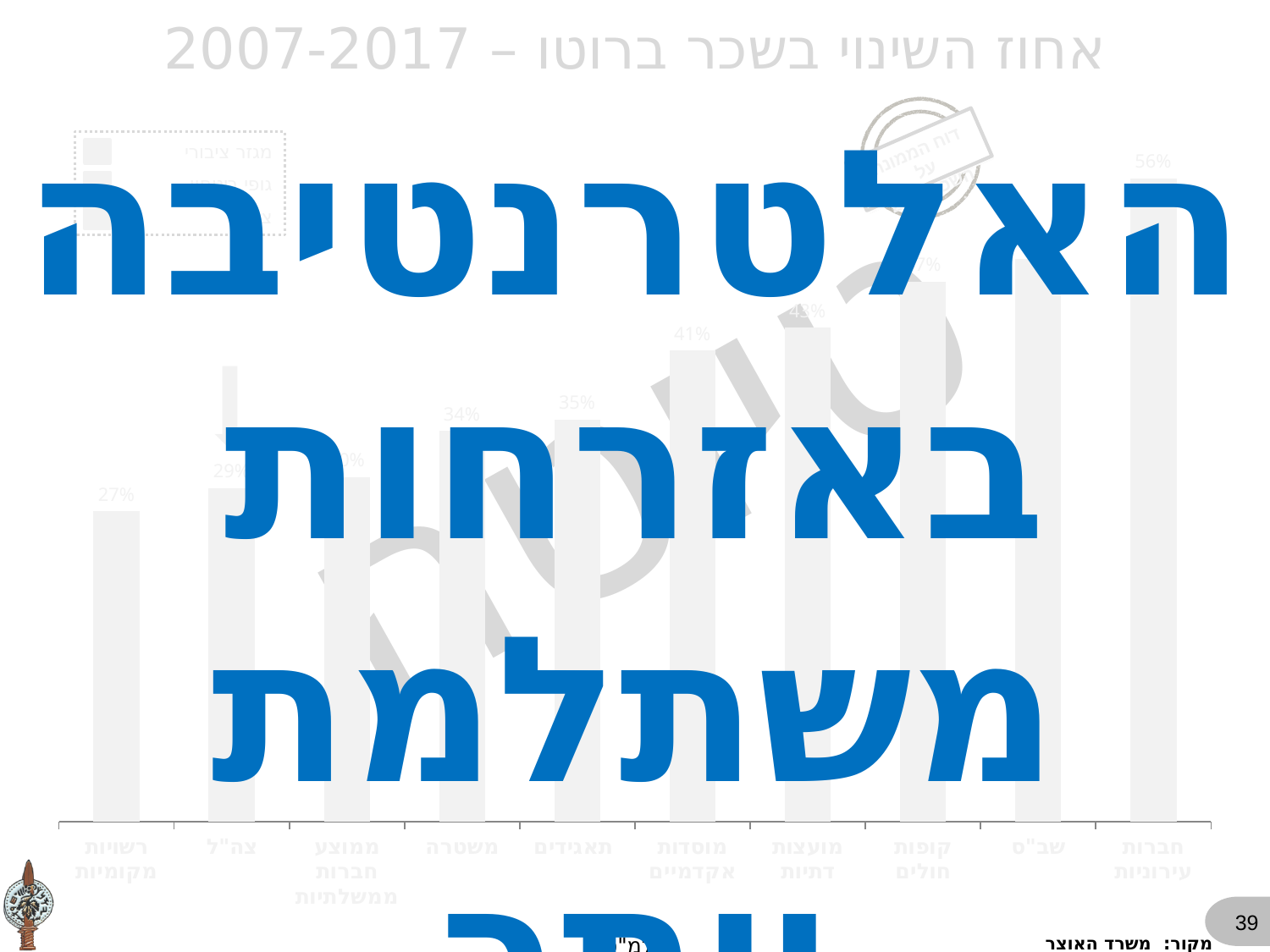
What is the difference between the values for מוסדות אקדמיים and משטרה? 7 percentage points What is the value for צה"ל? 29% What is the value for רשויות מקומיות? 27% Which is larger, the value for מוסדות אקדמיים or the value for צה"ל? מוסדות אקדמיים What is the value for חברות עירוניות? 56% What is the value for מוסדות אקדמיים? 41% What is the difference between the values for חברות עירוניות and רשויות מקומיות? 29 percentage points What is the value for תאגידים? 35% What is the value for משטרה? 34% How many categories are shown on the x axis of the chart? 10 What is the title of the chart? אחוז השינוי בשכר ברוטו – 2007-2017 What kind of chart is shown on the slide? bar chart